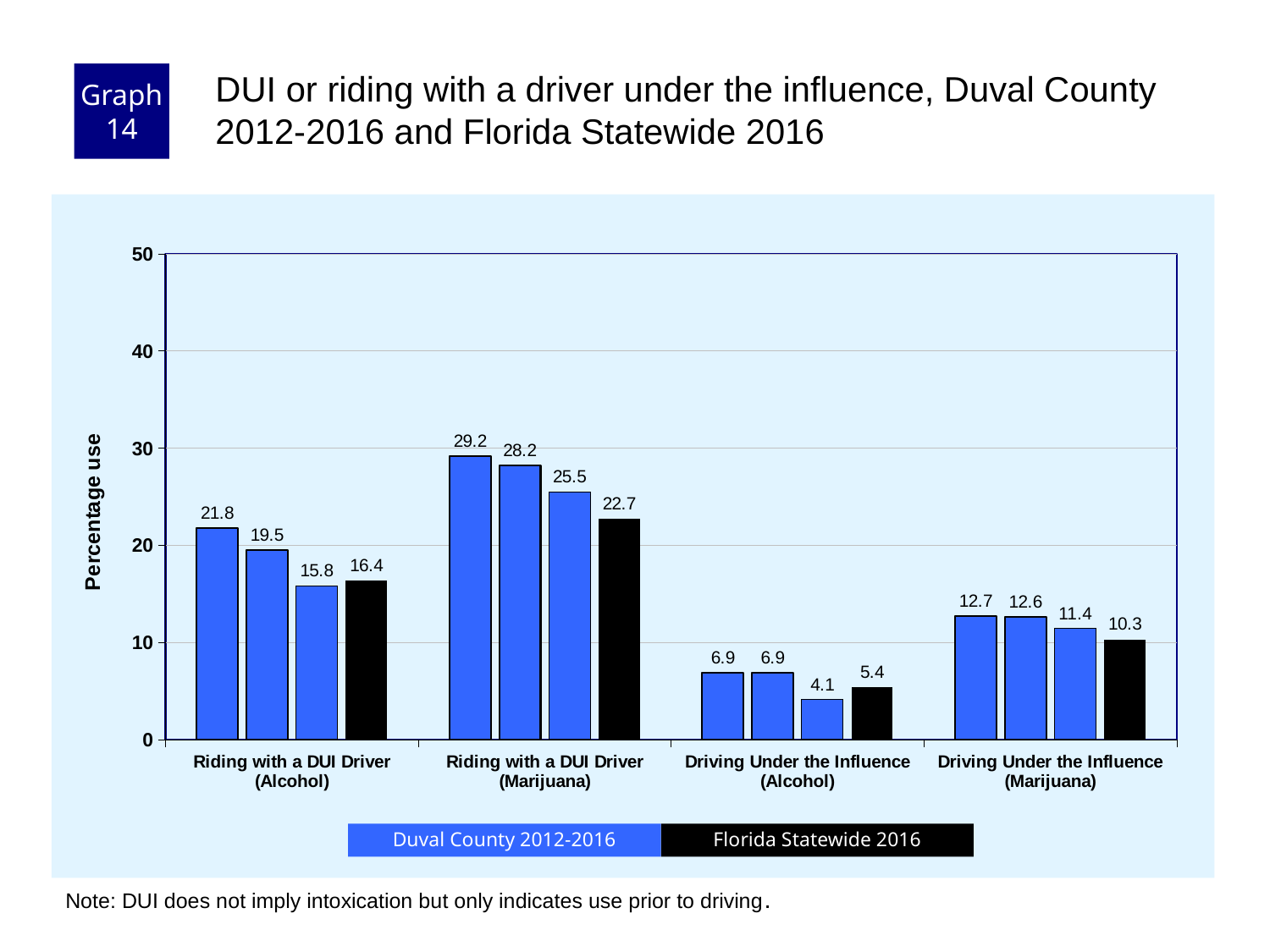
What is the Florida Statewide 2016 value for Driving Under the Influence (Alcohol)? 5.4 How many series does the legend list? 2 What is the label of the y axis? Percentage use Which category has the lowest bar on the chart? Driving Under the Influence (Alcohol) What kind of chart is shown on the slide? bar chart What is the difference between the Florida Statewide 2016 values for Riding with a DUI Driver (Marijuana) and Riding with a DUI Driver (Alcohol)? 6.3 Which category has the highest bar on the chart? Riding with a DUI Driver (Marijuana) Is the Florida Statewide 2016 value for Riding with a DUI Driver (Marijuana) larger or smaller than the Florida Statewide 2016 value for Driving Under the Influence (Marijuana)? larger How many categories are shown on the x axis? 4 What is the Florida Statewide 2016 value for Driving Under the Influence (Marijuana)? 10.3 What is the Florida Statewide 2016 value for Riding with a DUI Driver (Alcohol)? 16.4 What is the Florida Statewide 2016 value for Riding with a DUI Driver (Marijuana)? 22.7